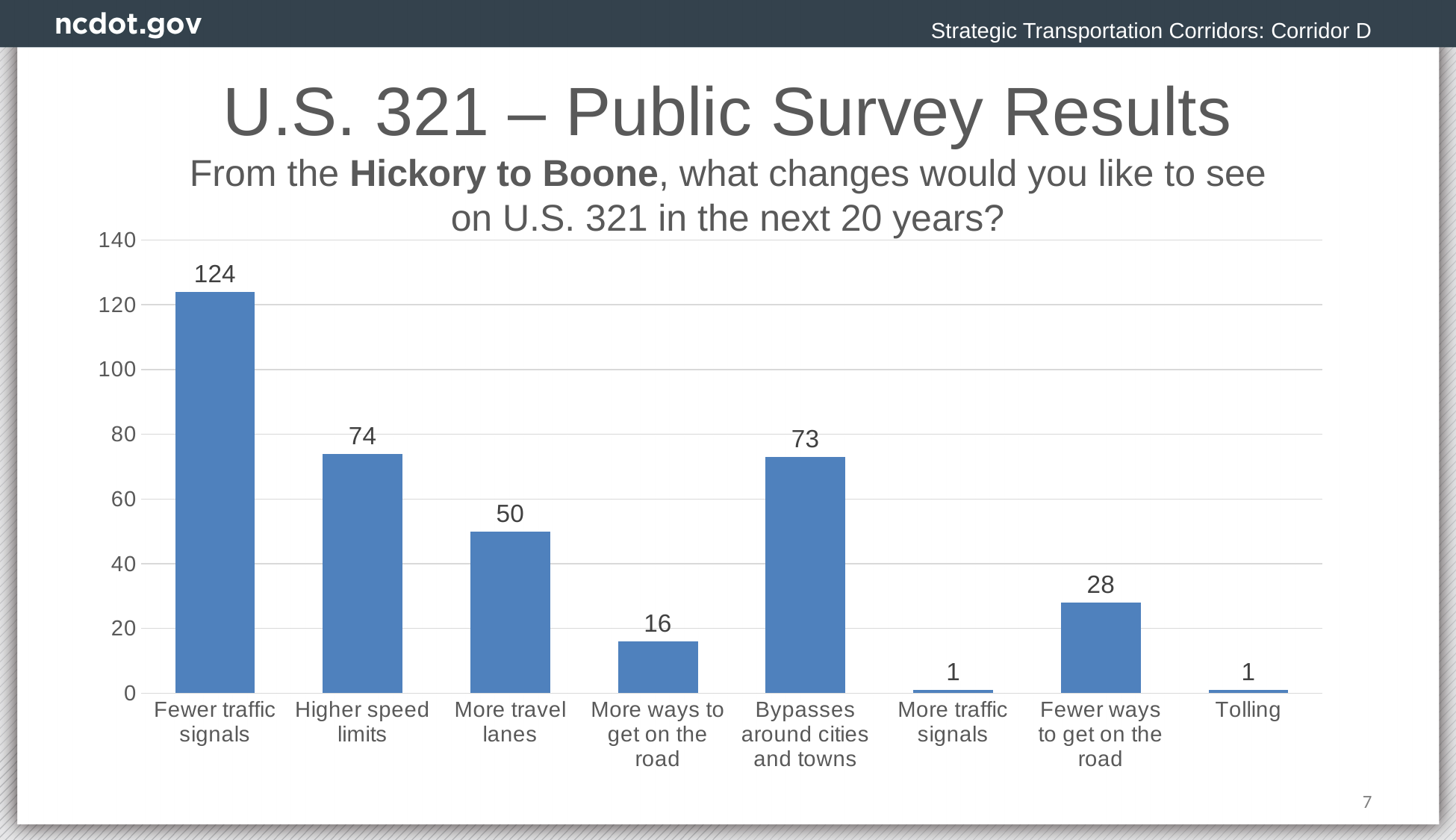
What is the value for "Fewer traffic signals"? 124 What is the value for "Tolling"? 1 What is the difference between "More travel lanes" and "More ways to get on the road"? 34 Is the value for "Fewer traffic signals" greater or less than 100? greater What is the difference between "Fewer traffic signals" and "Higher speed limits"? 50 What is the value for "Fewer ways to get on the road"? 28 What is the value for "Bypasses around cities and towns"? 73 Which is larger, "Higher speed limits" or "More travel lanes"? Higher speed limits What is the highest value shown on the y axis? 140 How many categories are shown on the x axis? 8 Which category has the highest value? Fewer traffic signals What kind of chart is shown on the slide? Bar chart